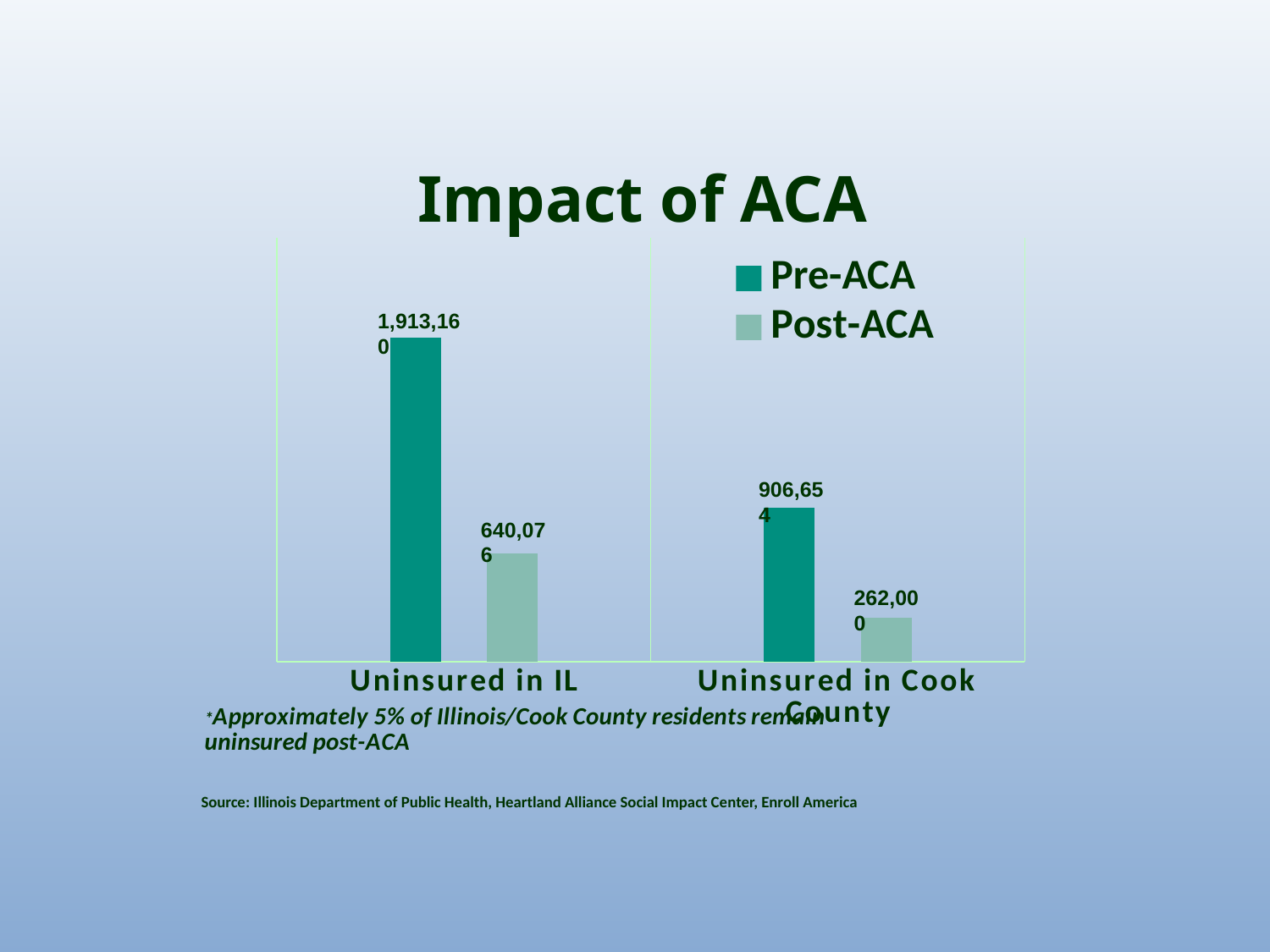
How many categories are shown on the x axis? 2 How many series does the legend list? 2 What is the Pre-ACA value for Uninsured in IL? 1,913,160 Which bar shows the highest value on the chart? Pre-ACA, Uninsured in IL What is the Post-ACA value for Uninsured in Cook County? 262,000 What type of chart is shown on the slide? Bar chart Which bar shows the lowest value on the chart? Post-ACA, Uninsured in Cook County Which is larger: the Post-ACA value for Uninsured in IL or the Pre-ACA value for Uninsured in Cook County? Pre-ACA value for Uninsured in Cook County What is the Pre-ACA value for Uninsured in Cook County? 906,654 What is the Post-ACA value for Uninsured in IL? 640,076 What is the difference between the Pre-ACA and Post-ACA values for Uninsured in IL? 1,273,084 What is the difference between the Pre-ACA and Post-ACA values for Uninsured in Cook County? 644,654